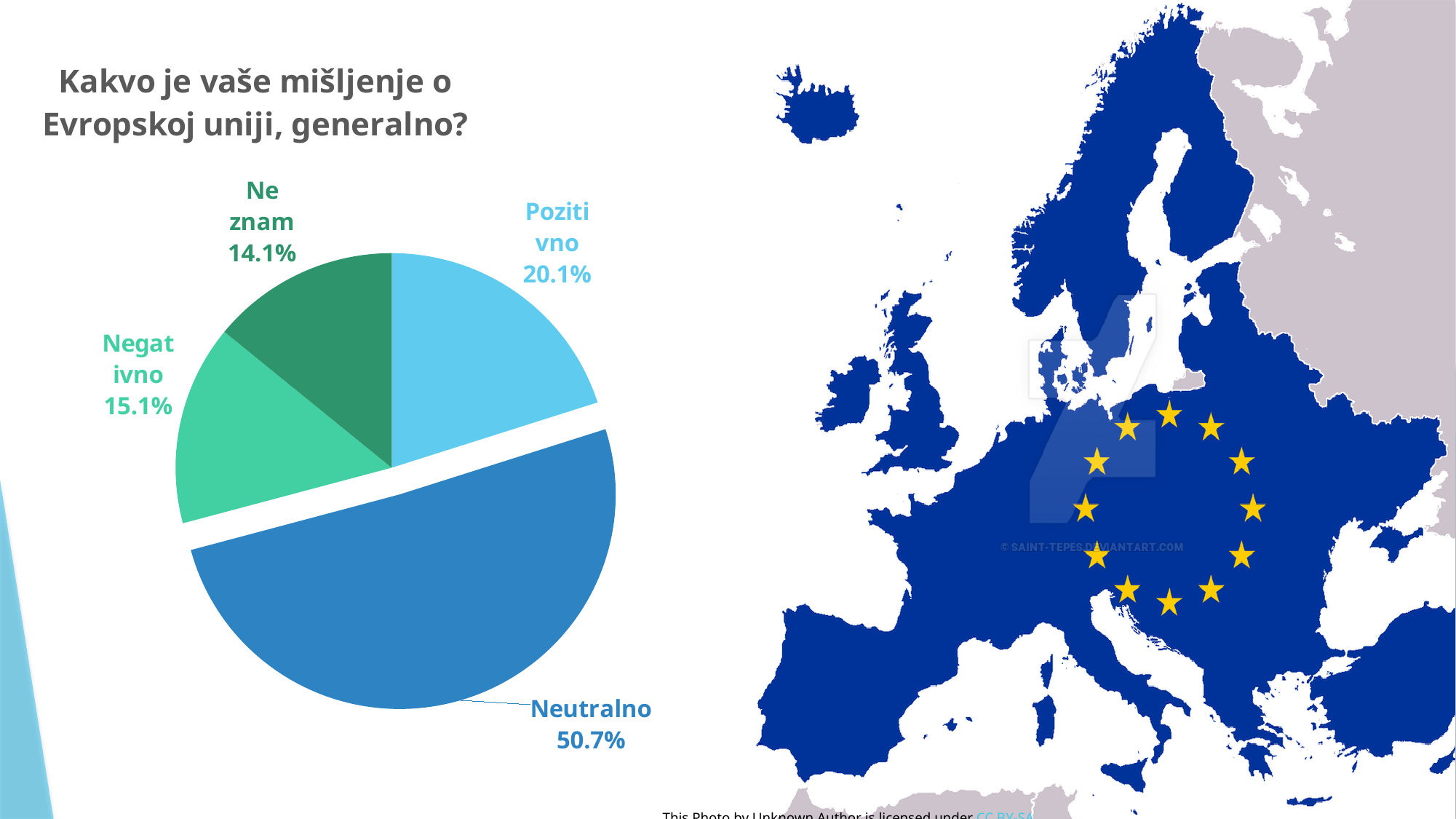
Which is larger, Pozitivno or Negativno? Pozitivno Which category has the largest share of the pie? Neutralno What is the title of the chart? Kakvo je vaše mišljenje o Evropskoj uniji, generalno? What is the difference between the Neutralno and Pozitivno values? 30.6% What kind of chart is shown on the slide? pie chart What is the value for Negativno? 15.1% What is the value for Ne znam? 14.1% What is the difference between the Negativno and Ne znam values? 1.0% What is the value for Neutralno? 50.7% What is the value for Pozitivno? 20.1% Which category has the smallest share of the pie? Ne znam How many slices does the pie chart have? 4